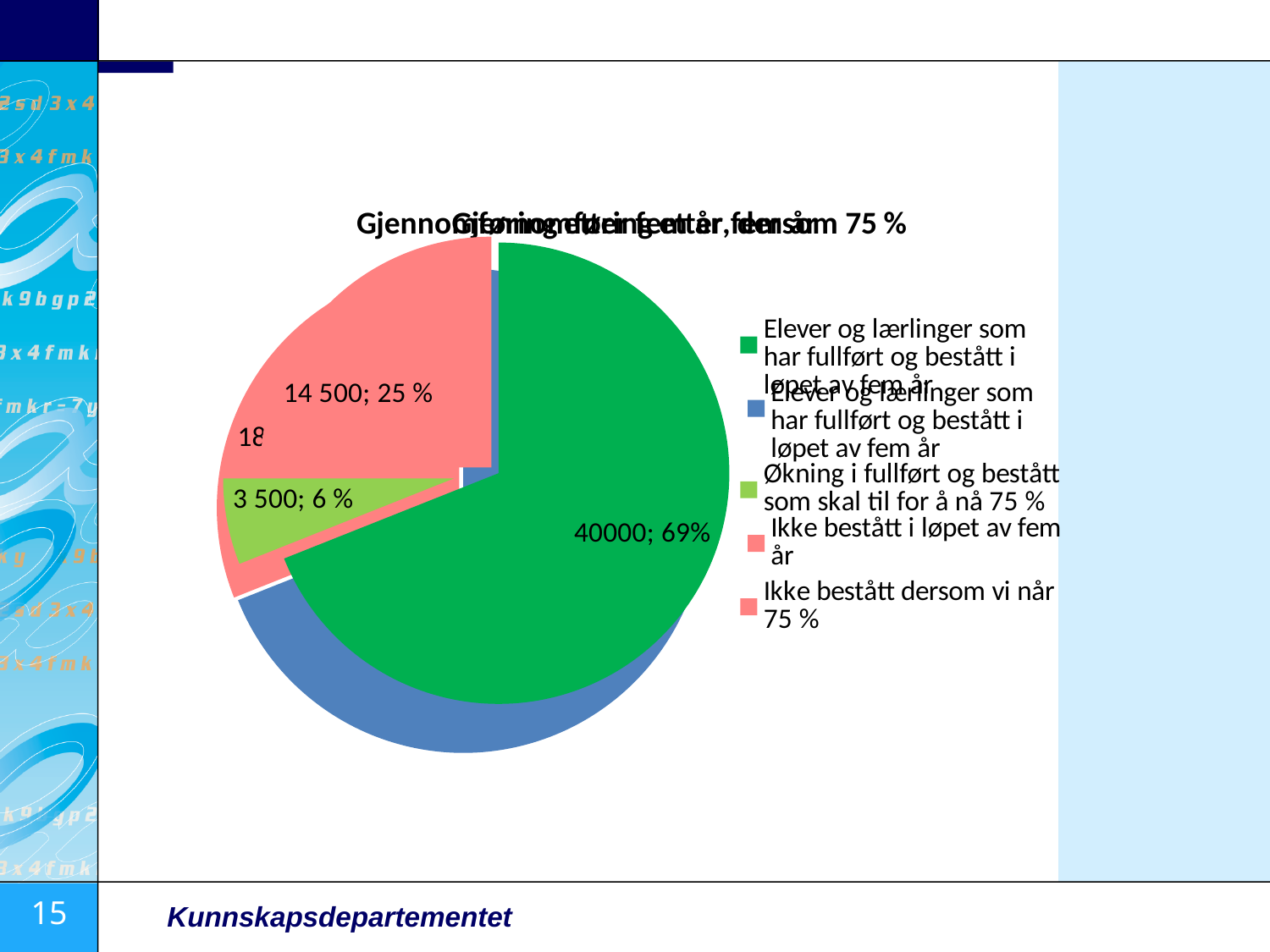
What colour is the legend marker for 'Økning i fullført og bestått som skal til for å nå 75 %'? light green In the front pie chart, which slice is the largest? the green slice (40000; 69%) In the front pie chart, what value is labelled on the light green slice for 'Økning i fullført og bestått som skal til for å nå 75 %'? 3 500; 6 % In the front pie chart, what value is labelled on the pink slice for 'Ikke bestått dersom vi når 75 %'? 14 500; 25 % What kind of chart is shown on the slide? pie chart In the front pie chart, which slice is the smallest? the light green slice (3 500; 6 %) How many entries does the legend list? 5 In the front pie chart, what share of the pie does the green slice represent? 69% In the front pie chart, what is the difference between the pink slice value (14 500) and the light green slice value (3 500)? 11 000 In the front pie chart, what value is labelled on the largest (green) slice? 40000; 69% In the front pie chart, what share of the pie does the light green slice represent? 6 % In the front pie chart, which is larger: the pink slice (14 500) or the light green slice (3 500)? the pink slice (14 500)